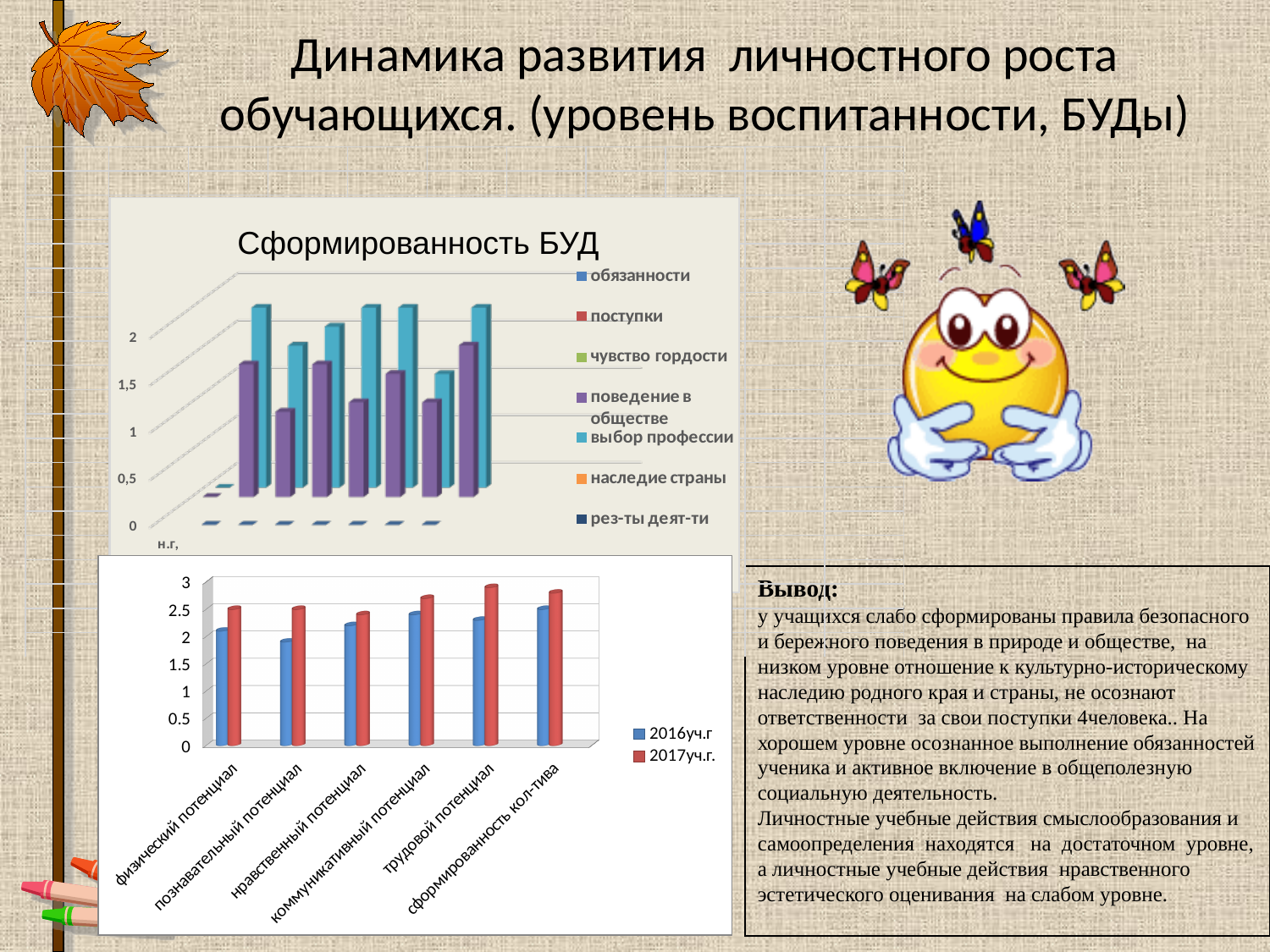
What is the title of the top chart? Сформированность БУД In the top chart 'Сформированность БУД', which series has the tallest bars? выбор профессии In the bottom chart, which series has the larger value for физический потенциал, 2016уч.г or 2017уч.г.? 2017уч.г. In the bottom chart, which category has the lowest value for the 2016уч.г series? познавательный потенциал How many series does the legend of the bottom chart list? 2 In the bottom chart, is the 2017уч.г. value for трудовой потенциал greater or less than 2.5? greater How many categories are shown on the x axis of the bottom chart? 6 In the bottom chart, which series has the larger value for трудовой потенциал, 2016уч.г or 2017уч.г.? 2017уч.г. In the bottom chart, is the 2016уч.г value for физический потенциал greater or less than 2.5? less What kind of chart is the bottom chart on the slide? bar chart In the bottom chart, is the 2017уч.г. value for коммуникативный потенциал greater or less than 2.5? greater How many series does the legend of the top chart 'Сформированность БУД' list? 7